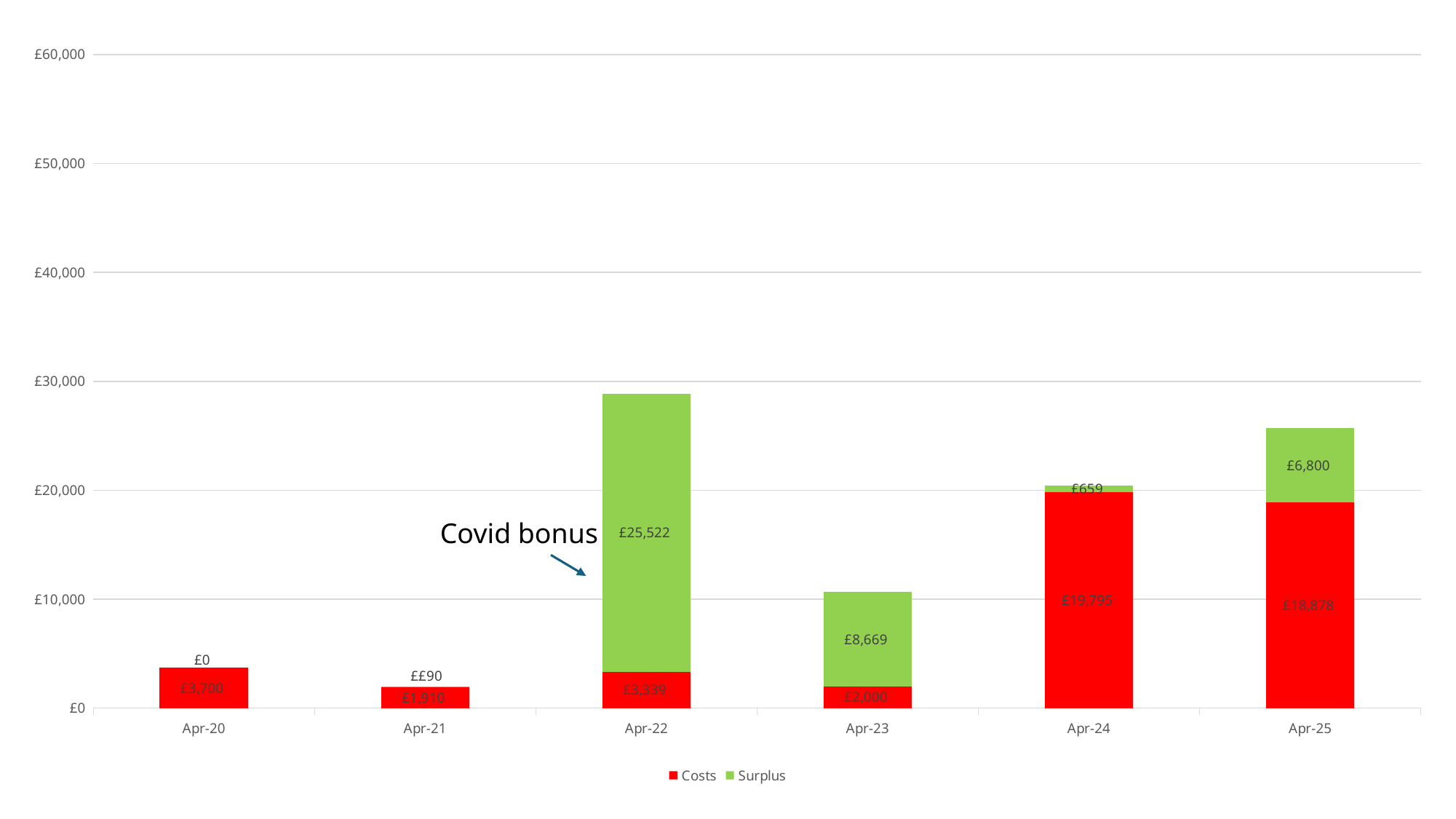
Which is larger, the Surplus for Apr-23 or the Surplus for Apr-25? Apr-23 Is the total height of the Apr-22 stacked bar greater or less than £30,000? less How many series does the legend list? 2 What is the Costs value for Apr-23? £2,000 What kind of chart is shown on the slide? Stacked bar chart How many years are shown on the x axis? 6 What is the Costs value for Apr-24? £19,795 What is the total of the Apr-25 stacked bar (Costs plus Surplus)? £25,678 Which year has the lowest Costs? Apr-21 What is the Surplus value for Apr-22? £25,522 What is the difference between the Costs for Apr-24 and Apr-25? £917 Which year has the highest Surplus? Apr-22